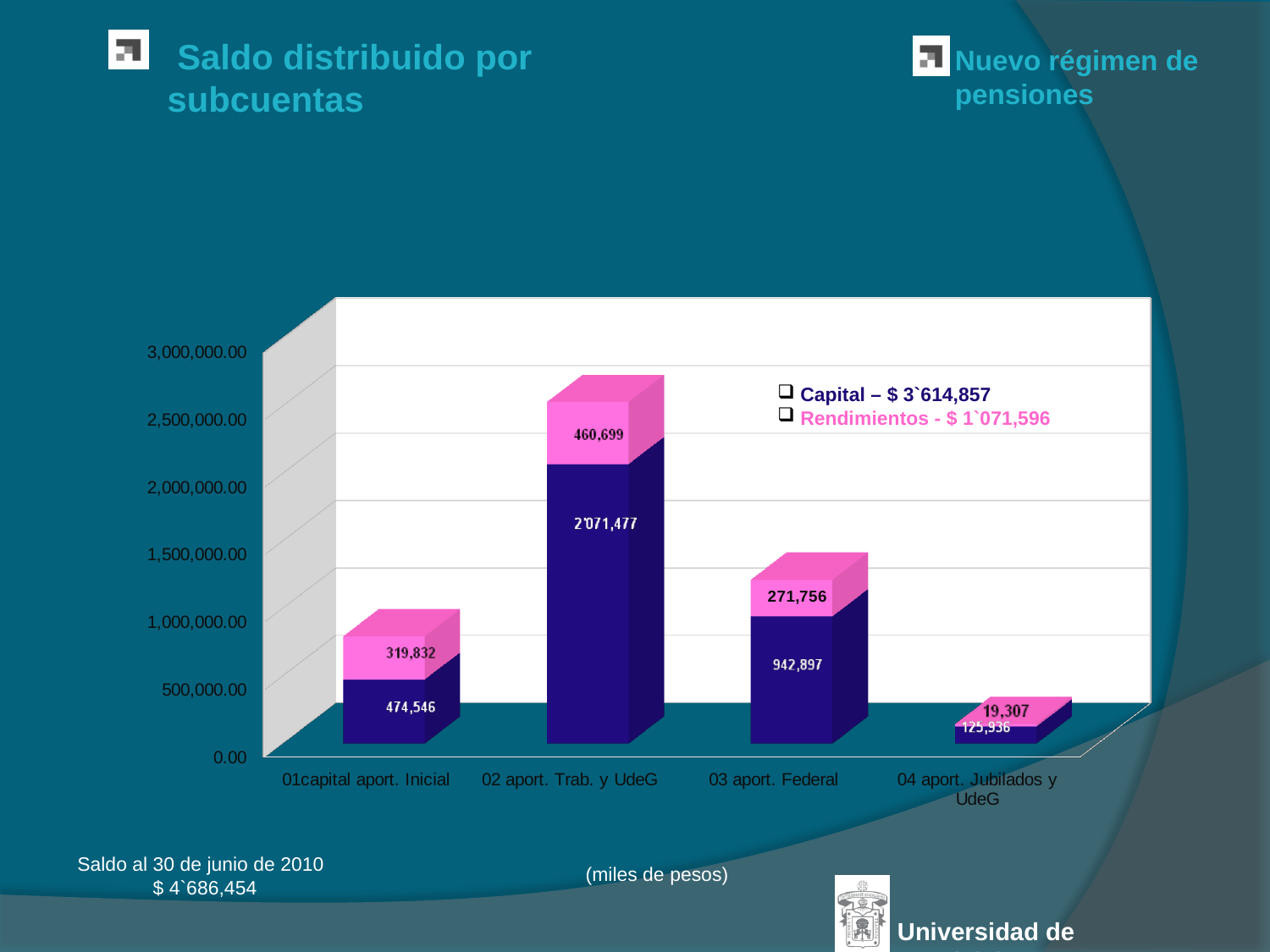
Which is larger, the Rendimientos value for 01capital aport. Inicial or for 03 aport. Federal? 01capital aport. Inicial What kind of chart is shown on the slide? Stacked bar chart What is the Rendimientos value for 04 aport. Jubilados y UdeG? 19,307 What is the difference between the Capital values for 03 aport. Federal and 01capital aport. Inicial? 468,351 What is the Capital value for 01capital aport. Inicial? 474,546 Which category has the lowest Rendimientos value? 04 aport. Jubilados y UdeG What is the Rendimientos value for 02 aport. Trab. y UdeG? 460,699 Which category has the highest Capital value? 02 aport. Trab. y UdeG How many series does the legend list? 2 What is the Capital value for 03 aport. Federal? 942,897 How many categories are shown on the x axis? 4 What is the total of the stacked bar for 03 aport. Federal? 1,214,653